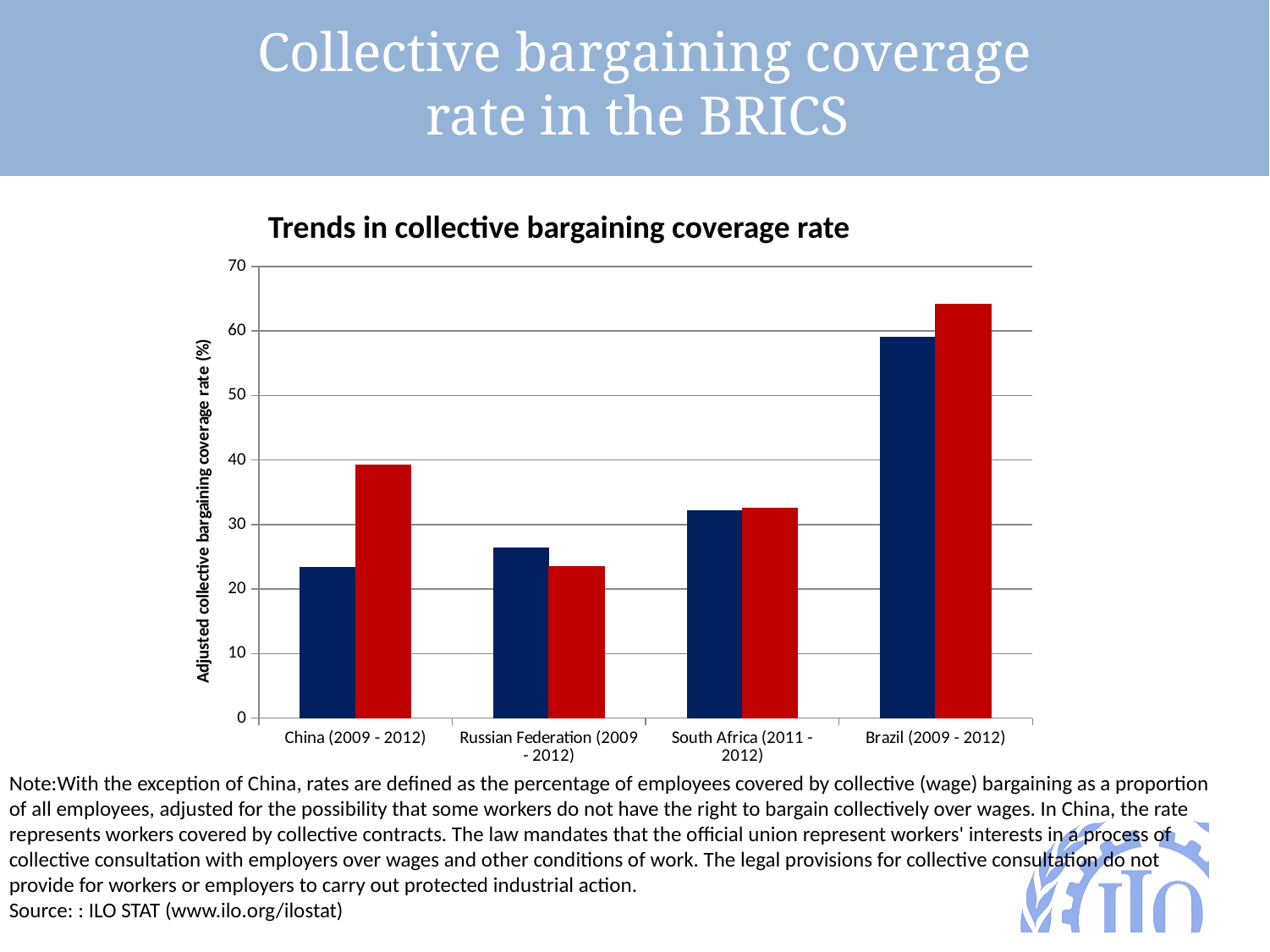
Is the value of the red bar for Brazil (2009 - 2012) greater or less than 60? greater What is the title of the chart? Trends in collective bargaining coverage rate What kind of chart is shown on the slide? bar chart Which country has the highest bars in the chart? Brazil (2009 - 2012) Is the value of the blue bar for China (2009 - 2012) greater or less than 30? less For Russian Federation (2009 - 2012), which bar is taller, the blue bar or the red bar? the blue bar How many countries (categories) are shown on the x axis of the chart? 4 Is the value of the blue bar for Brazil (2009 - 2012) greater or less than 50? greater What is the label of the vertical axis of the chart? Adjusted collective bargaining coverage rate (%) For China (2009 - 2012), which bar is taller, the blue bar or the red bar? the red bar